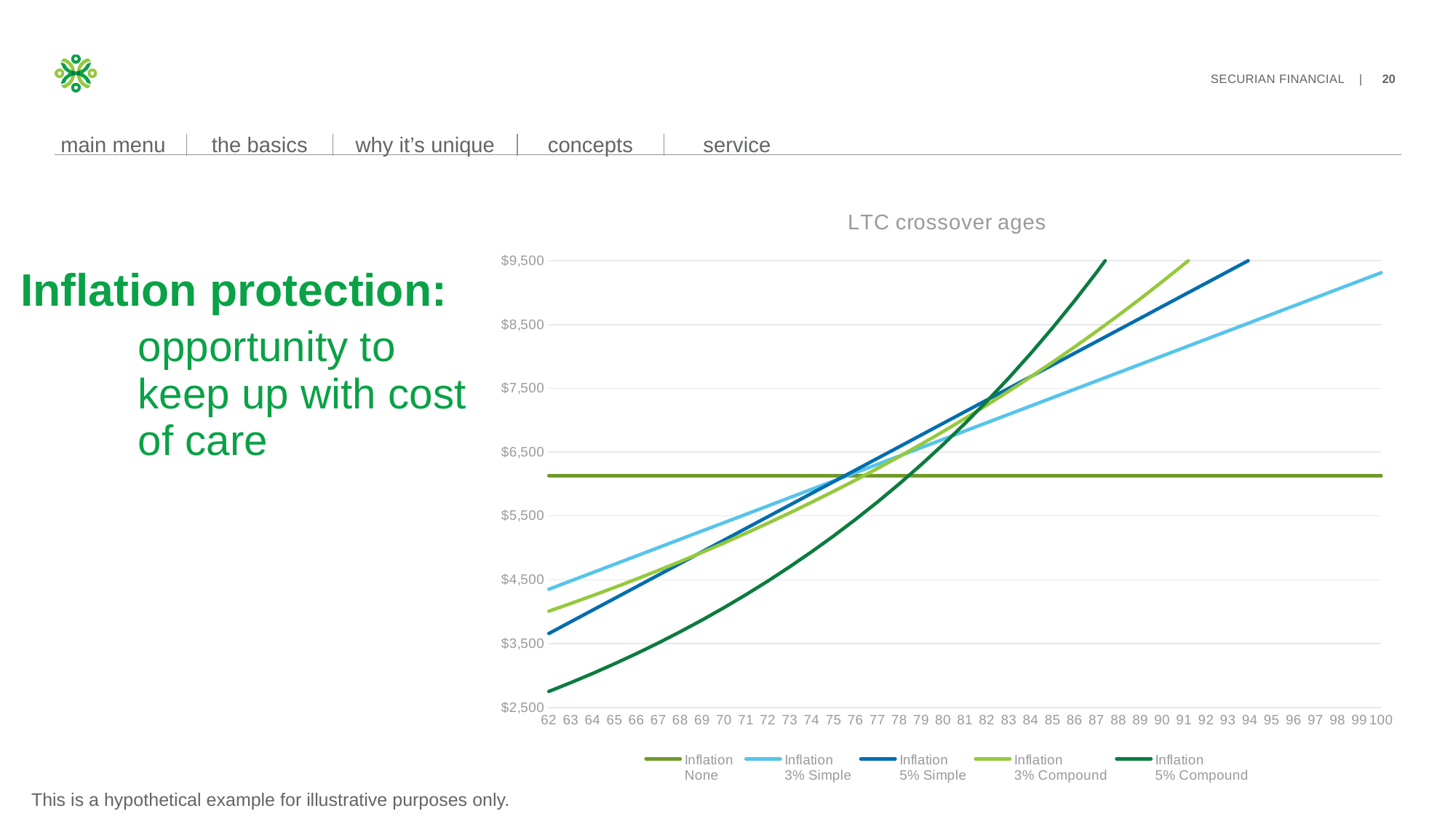
Is the value of the Inflation None line greater or less than $5,500? greater What kind of chart is shown on the slide? line chart How many ages are shown along the x axis of the chart? 39 Which series has the lowest value at age 62? Inflation 5% Compound Which series is plotted as a flat horizontal line? Inflation None At age 62, which is larger: the Inflation 3% Simple value or the Inflation 5% Compound value? Inflation 3% Simple What is the title of the chart? LTC crossover ages Is the value of the Inflation 3% Simple line at age 100 greater or less than $8,500? greater Does the Inflation 3% Simple line rise or fall as age increases? rise Is the value of the Inflation 5% Compound line at age 62 greater or less than $3,500? less How many series does the chart's legend list? 5